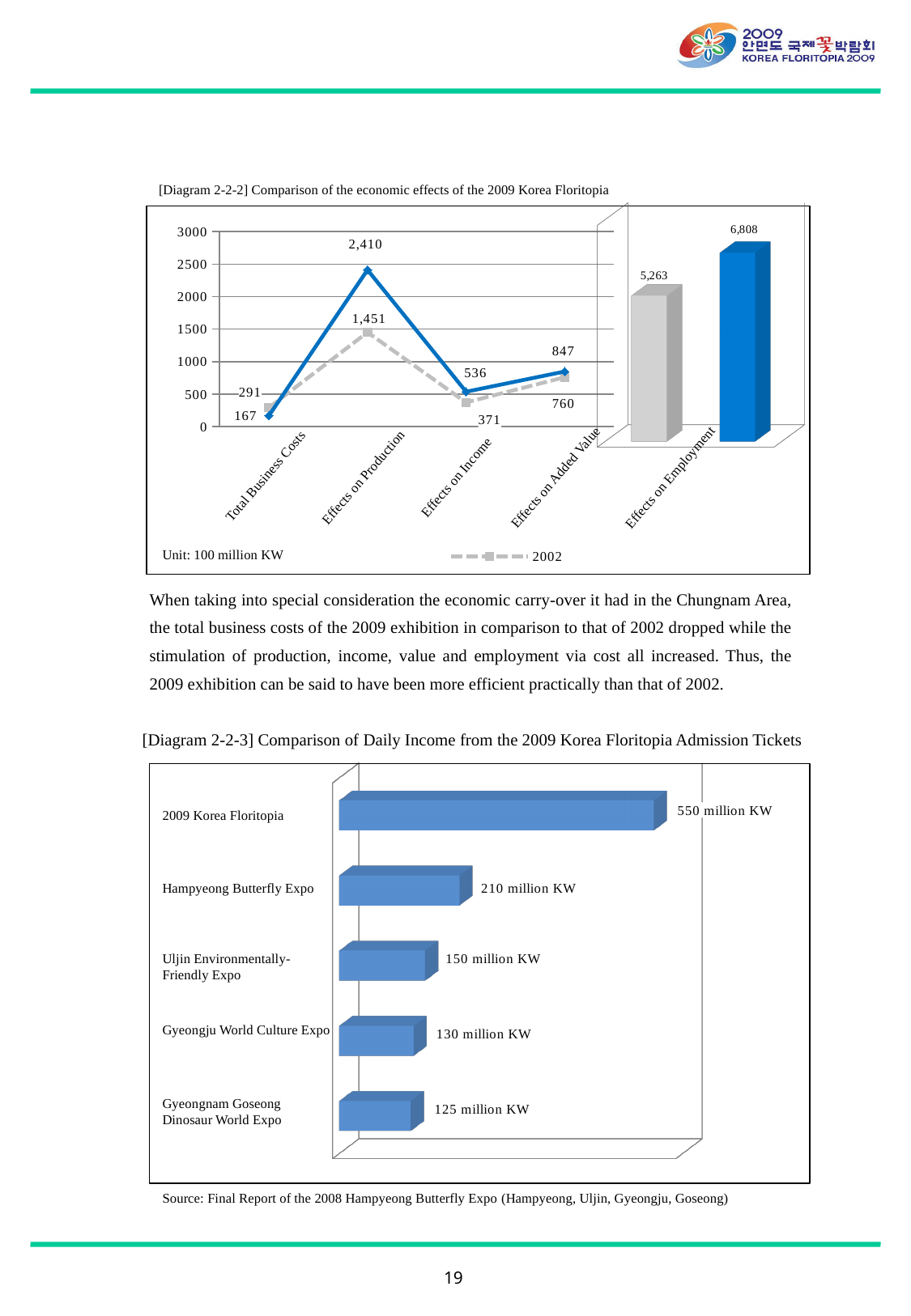
In Diagram 2-2-2, what is the 2002 value for Total Business Costs? 291 In Diagram 2-2-2, which is larger for Effects on Income: the 2002 value or the solid blue line value? the solid blue line value (536) In Diagram 2-2-3, what is the daily income for the Hampyeong Butterfly Expo? 210 million KW In Diagram 2-2-2, what is the difference between the two Effects on Employment bars (6,808 and 5,263)? 1,545 In Diagram 2-2-2, what is the 2002 value for Effects on Production? 1,451 In Diagram 2-2-2, what is the value shown on the solid blue line for Effects on Production? 2,410 In Diagram 2-2-3, what is the difference in daily income between the 2009 Korea Floritopia and the Gyeongnam Goseong Dinosaur World Expo? 425 million KW In Diagram 2-2-3, which expo has the highest daily income from admission tickets? 2009 Korea Floritopia In Diagram 2-2-2, what is the value of the blue bar for Effects on Employment? 6,808 How many expos are compared in Diagram 2-2-3? 5 What type of chart is Diagram 2-2-3? bar chart In Diagram 2-2-2, what unit is stated for the values? 100 million KW